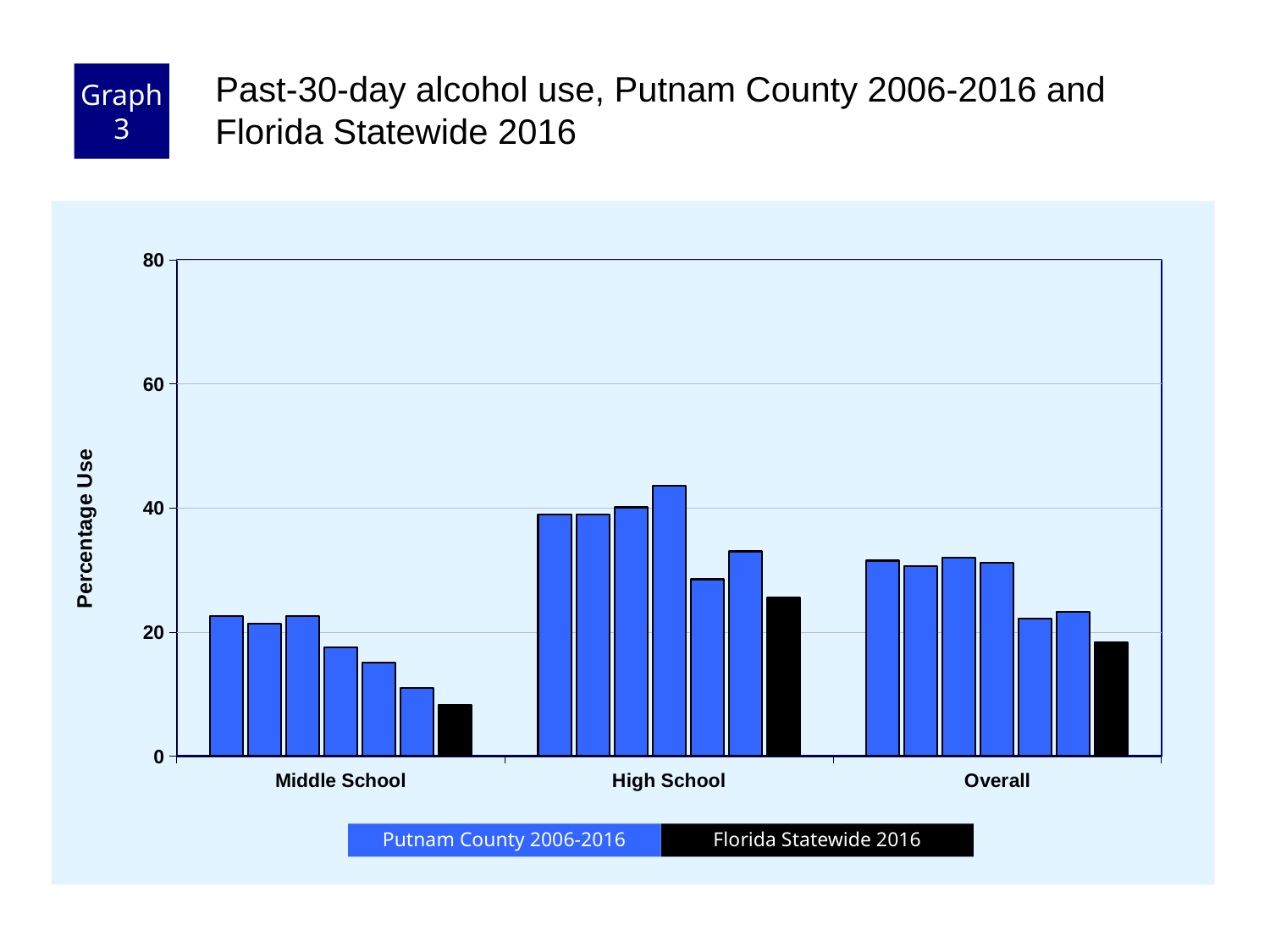
Is the Florida Statewide 2016 value for Middle School greater or less than 20? less Which category has the highest Florida Statewide 2016 value? High School How many categories are shown on the x axis? 3 Do the Putnam County 2006-2016 bars for Middle School generally rise or fall from left to right? fall How many series does the legend list? 2 Is the Florida Statewide 2016 value for High School greater or less than 20? greater Is the Florida Statewide 2016 value for Overall greater or less than 20? less What kind of chart is shown on the slide? bar chart What is the title of the y axis? Percentage Use Which category has the lowest Florida Statewide 2016 value? Middle School Which is larger, the Florida Statewide 2016 value for Middle School or for Overall? Overall